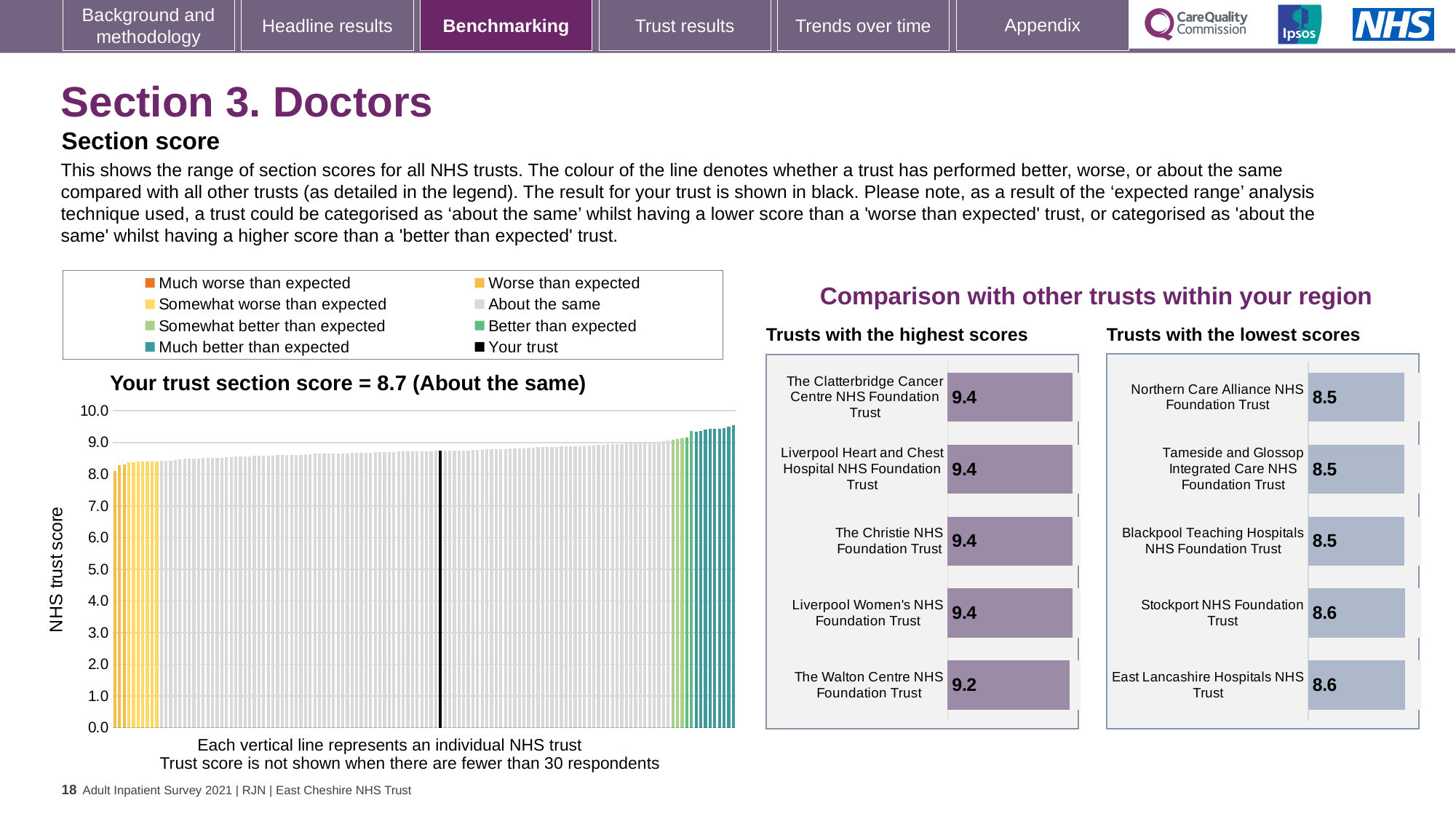
What is the y-axis label on the left chart? NHS trust score How many entries does the legend above the left chart list? 8 In the 'Trusts with the highest scores' chart, how many trusts are shown? 5 In the 'Trusts with the lowest scores' chart, which has the larger score: Stockport NHS Foundation Trust or Northern Care Alliance NHS Foundation Trust? Stockport NHS Foundation Trust In the 'Trusts with the highest scores' chart, what is the score for The Walton Centre NHS Foundation Trust? 9.2 On the left chart, what category is your trust placed in according to the chart title? About the same In the 'Trusts with the highest scores' chart, which trust has the lowest score? The Walton Centre NHS Foundation Trust In the 'Trusts with the highest scores' chart, what is the difference between the score for The Clatterbridge Cancer Centre NHS Foundation Trust and The Walton Centre NHS Foundation Trust? 0.2 On the left chart, do the trust scores rise or fall from left to right along the x axis? rise On the left chart, what is your trust's section score as stated in the chart title? 8.7 What kind of chart is the left chart showing the range of section scores for all NHS trusts? bar chart In the 'Trusts with the lowest scores' chart, what is the score for Stockport NHS Foundation Trust? 8.6